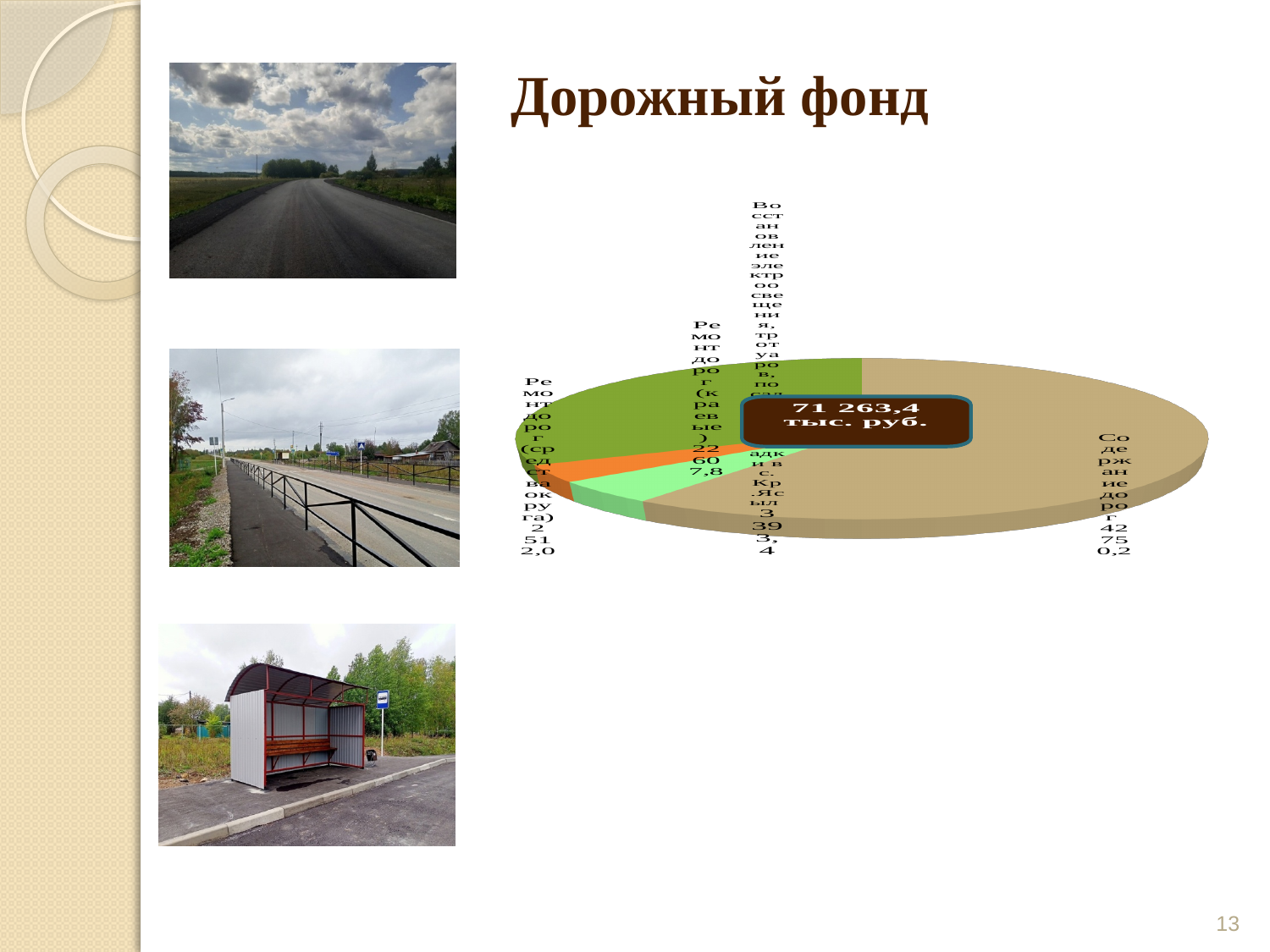
What value is shown for the slice "Ремонт дорог (средства округа)"? 2512,0 What kind of chart is shown on the slide? pie chart Which is larger: "Содержание дорог" or "Ремонт дорог (краевые)"? Содержание дорог Which slice of the pie chart is the largest? Содержание дорог Which slice of the pie chart is the smallest? Ремонт дорог (средства округа) What is the difference between the values for "Содержание дорог" and "Ремонт дорог (краевые)"? 20142,4 How many slices does the pie chart have? 4 What total amount is printed in the centre of the pie chart? 71 263,4 тыс. руб. What is the title of the slide containing the pie chart? Дорожный фонд What value is shown for the slice "Содержание дорог"? 42750,2 What value is shown for the slice "Ремонт дорог (краевые)"? 22607,8 What share of the total 71 263,4 does "Содержание дорог" (42750,2) represent? 60%